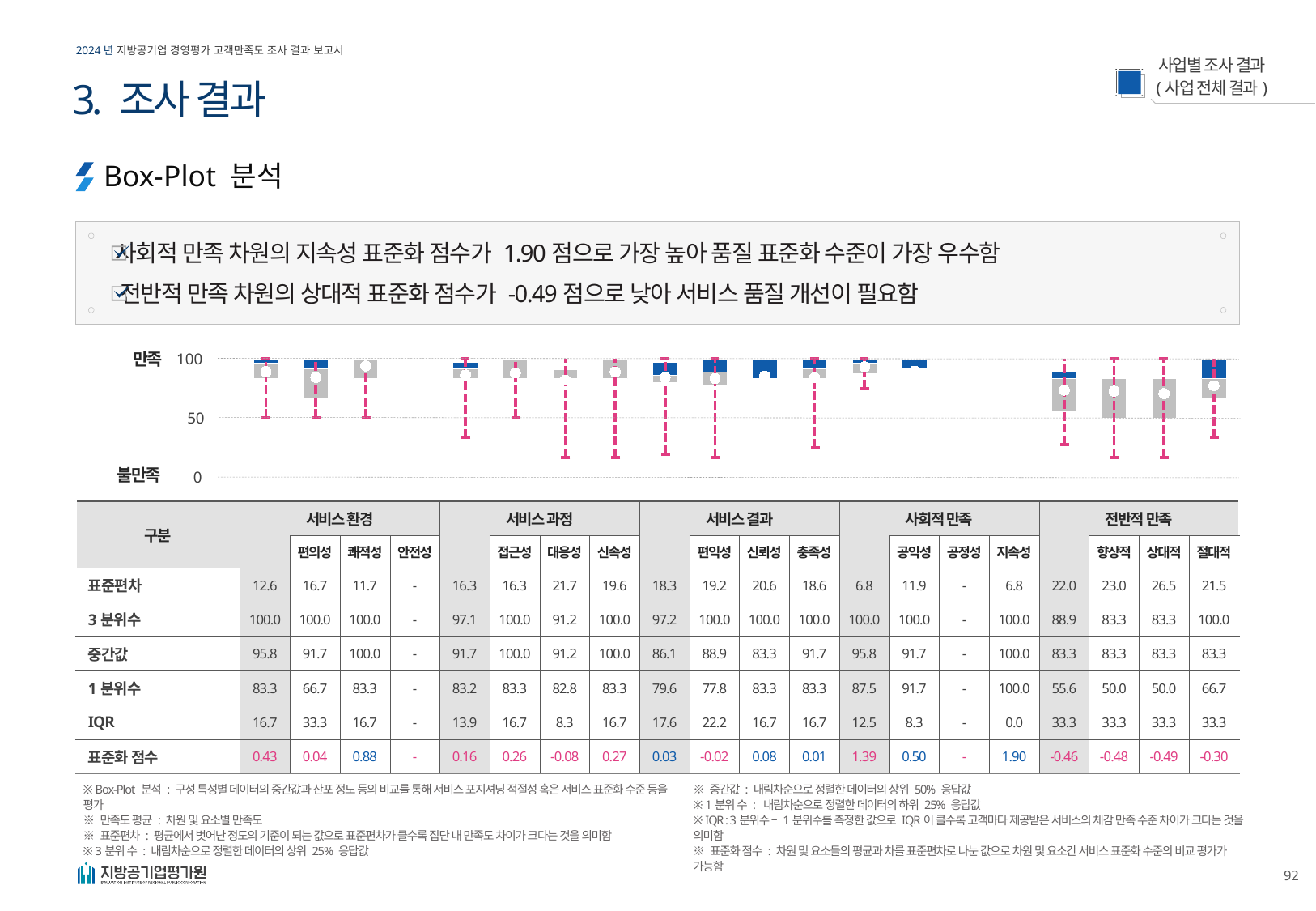
What kind of chart is shown on the slide? Box plot What label appears at the bottom of the y axis, next to 0? 불만족 What is the difference between the 3 분위수 and the 1 분위수 for 쾌적성? 16.7 What is the highest value shown on the y axis of the box plot? 100 Which has the larger 중간값: the 서비스 환경 overall column or the 전반적 만족 overall column? 서비스 환경 What is the IQR for 지속성? 0.0 What is the 중간값 (median) for 편의성 under 서비스 환경? 91.7 Is the 중간값 for 상대적 greater or less than 50? greater Which item has the highest 표준화 점수? 지속성 What is the 1 분위수 for 향상적 under 전반적 만족? 50.0 Which item has the lowest 표준화 점수? 상대적 What is the 표준화 점수 for 지속성 under 사회적 만족? 1.90